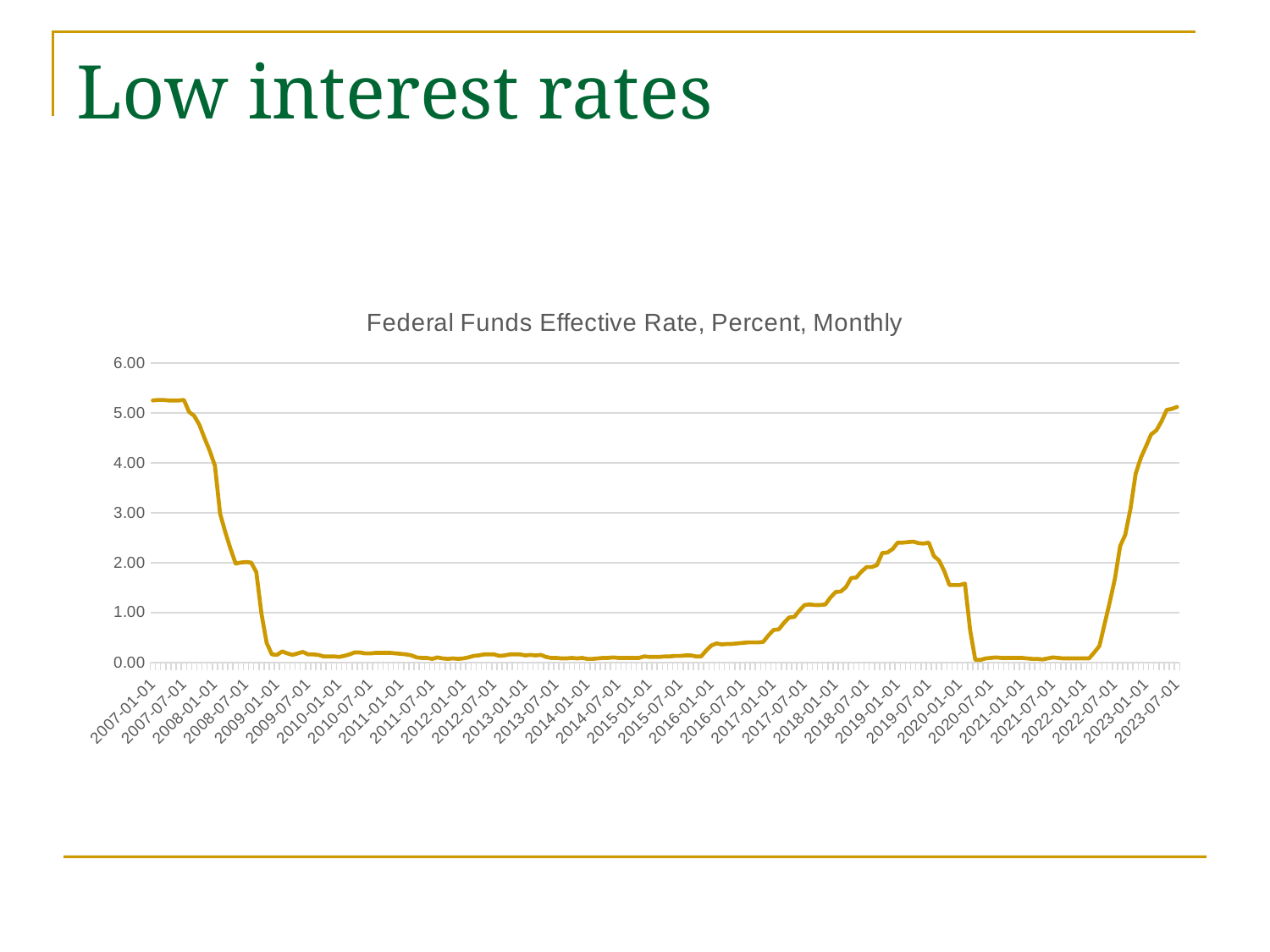
Is the value for 2021-01-01 greater or less than 1.00? less Does the rate rise or fall between 2022-01-01 and 2023-07-01? rise Is the value for 2016-01-01 greater or less than 1.00? less Is the value for 2019-01-01 greater or less than 2.00? greater What kind of chart is shown on the slide? line chart Does the rate rise or fall between 2007-07-01 and 2009-01-01? fall Does the rate rise or fall between 2016-01-01 and 2019-01-01? rise What is the highest value shown on the vertical axis of the chart? 6.00 What is the title of the chart? Federal Funds Effective Rate, Percent, Monthly